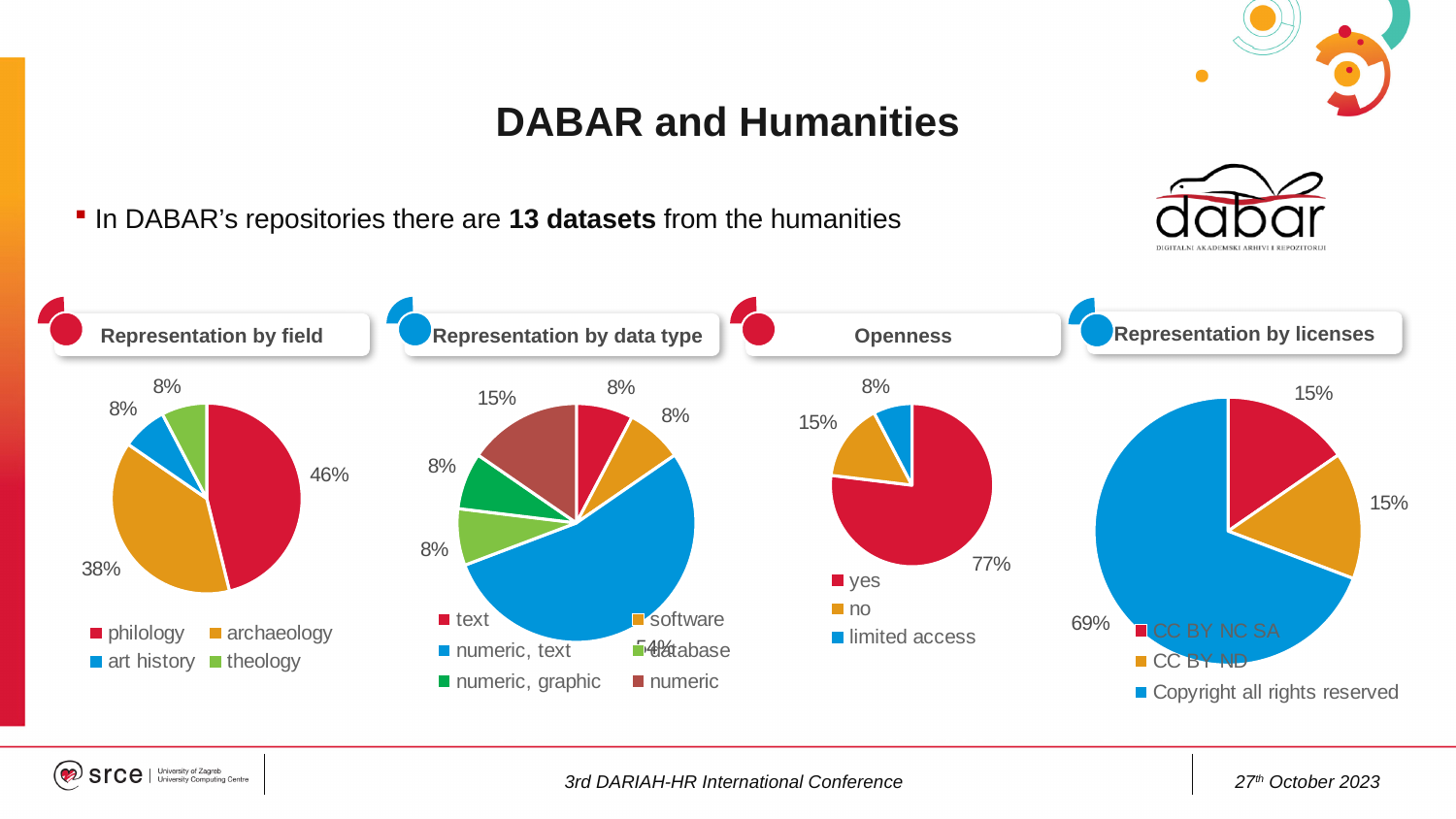
In the 'Representation by data type' chart, which data type has the largest share? numeric, text In the 'Representation by field' chart, what is the difference between the philology and archaeology shares? 8% What type of chart is the 'Openness' chart? pie chart In the 'Representation by field' chart, what share does philology have? 46% In the 'Representation by licenses' chart, what share is 'Copyright all rights reserved'? 69% How many categories does the legend of the 'Representation by field' chart list? 4 In the 'Representation by field' chart, which field has the largest share? philology In the 'Representation by licenses' chart, what is the difference between 'Copyright all rights reserved' and 'CC BY ND'? 54% In the 'Representation by data type' chart, what share does numeric have? 15% How many categories does the legend of the 'Representation by data type' chart list? 6 In the 'Openness' chart, which is larger, 'no' or 'limited access'? no In the 'Openness' chart, what share is 'yes'? 77%